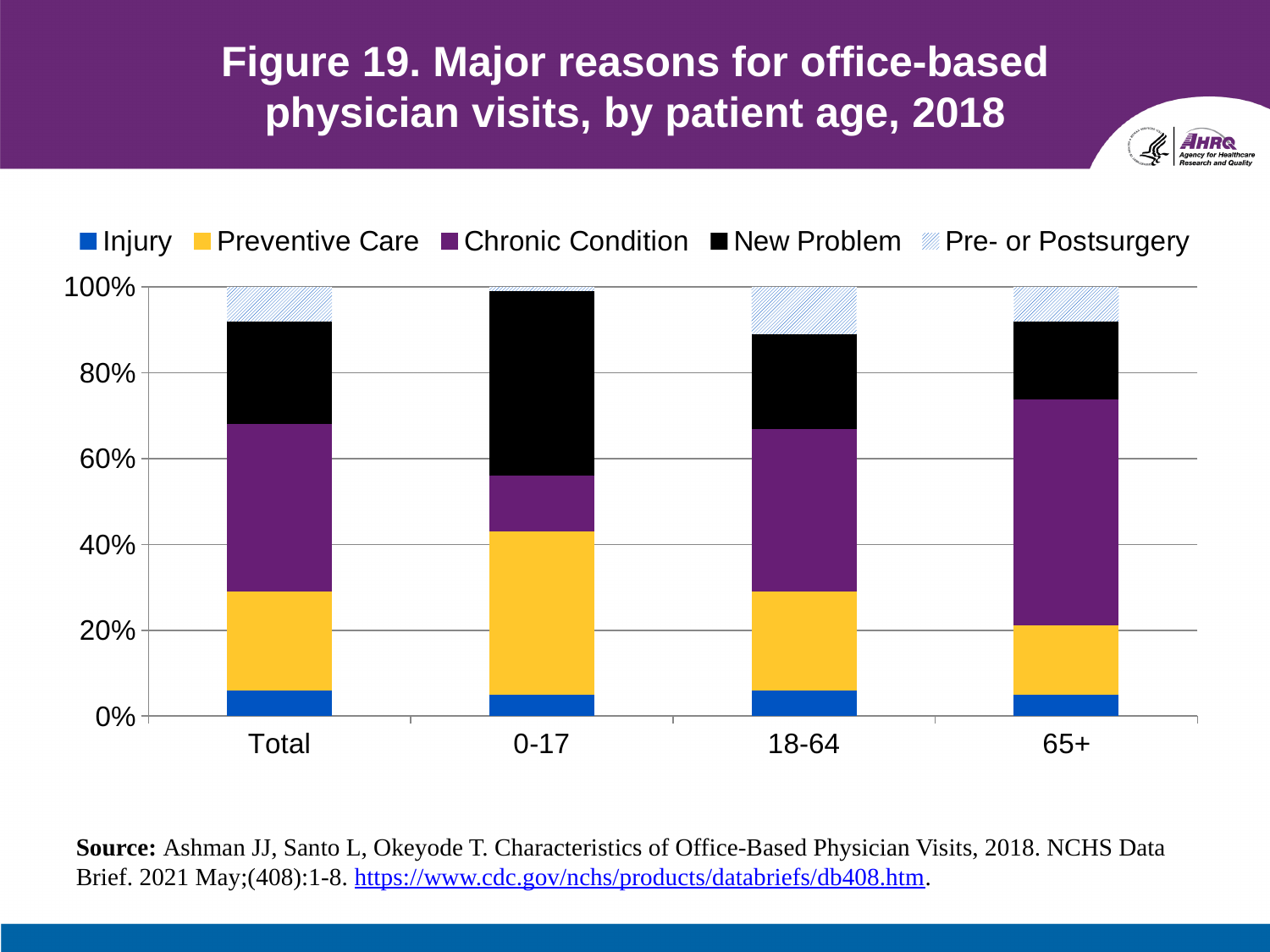
Is the Chronic Condition share for 65+ larger or smaller than the Chronic Condition share for 0-17? larger Is the Injury share for Total greater or less than 20%? less Is the Preventive Care share for 0-17 larger or smaller than the Preventive Care share for 65+? larger Is the Chronic Condition share for 65+ greater or less than 40%? greater Which series is shown in yellow in the legend? Preventive Care How many series does the legend list? 5 What is the title of the chart? Figure 19. Major reasons for office-based physician visits, by patient age, 2018 Which age group has the smallest Chronic Condition share? 0-17 How many patient age categories are shown on the x axis? 4 What kind of chart is shown on the slide? Stacked bar chart Which age group has the largest Chronic Condition share? 65+ Which age group has the largest Preventive Care share? 0-17